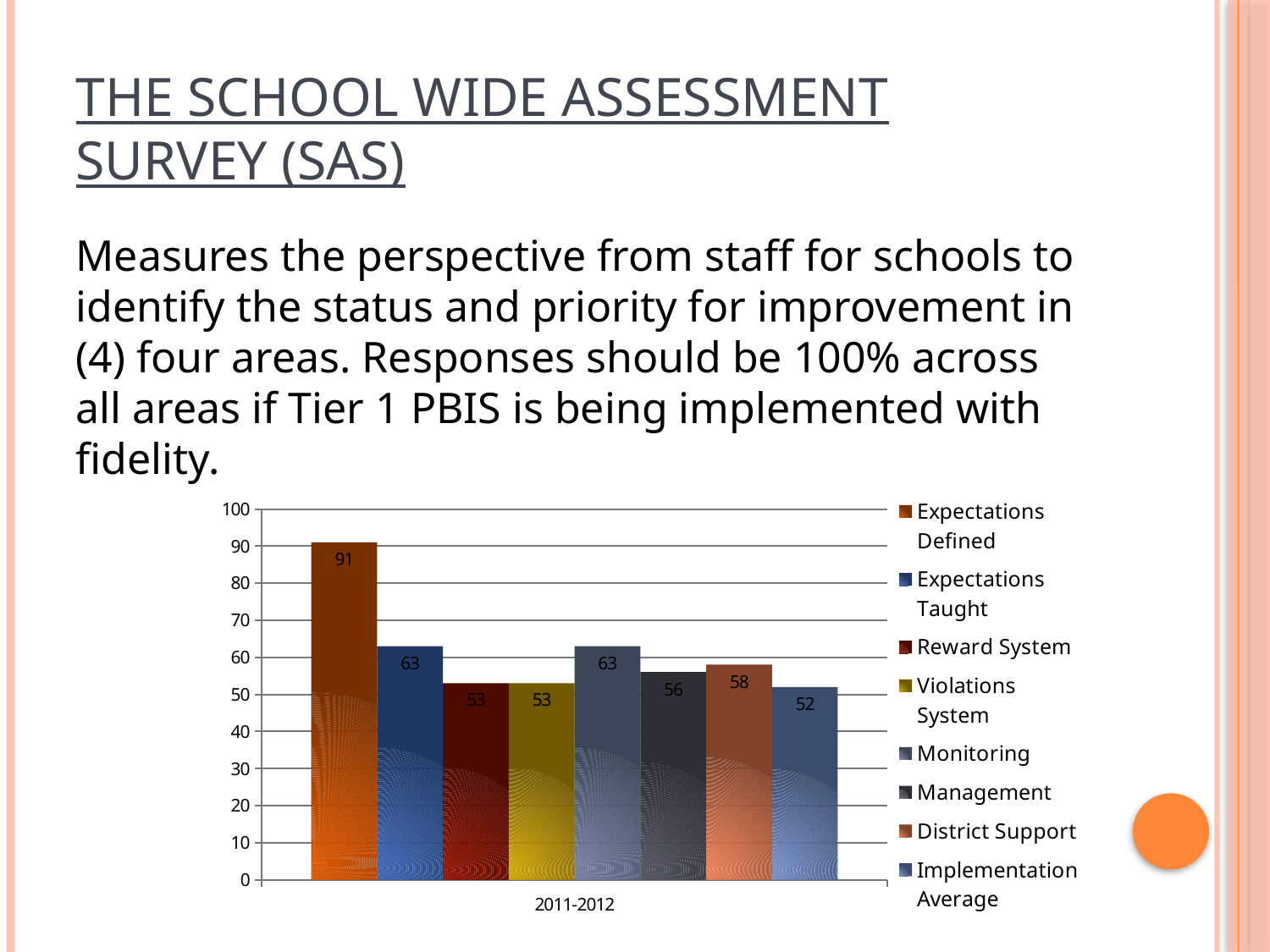
What is the difference between Expectations Defined and Reward System? 38 What is the value for Implementation Average? 52 Which series has the lowest value? Implementation Average What is the value for Expectations Defined? 91 What is the value for Expectations Taught? 63 Which series has the highest value? Expectations Defined What is the label on the x axis? 2011-2012 What kind of chart is shown? bar chart Is the value for Monitoring greater or less than 60? greater How many series does the legend list? 8 Which is larger, Management or District Support? District Support What is the value for District Support? 58